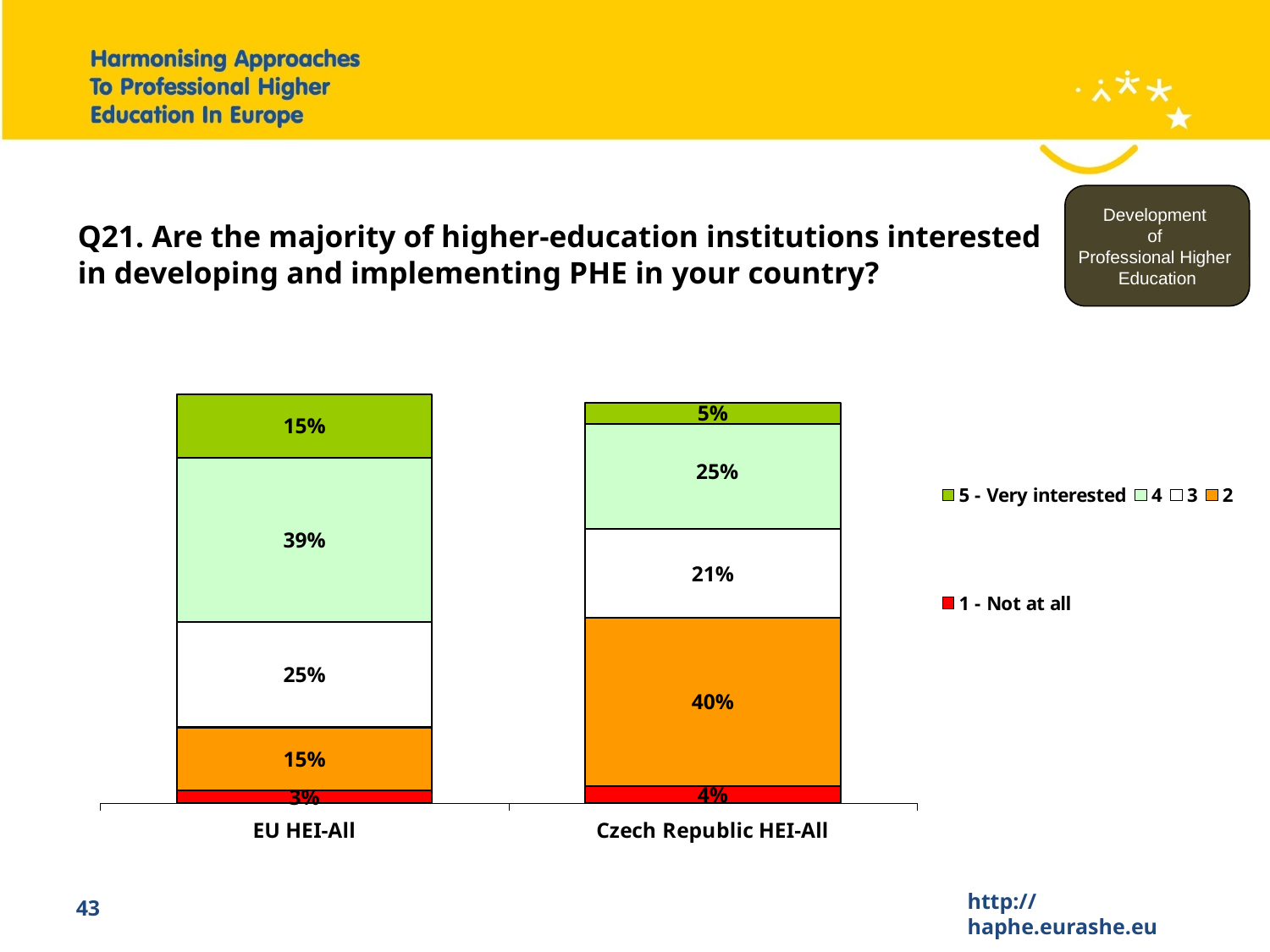
Which category has the larger '5 - Very interested' segment, EU HEI-All or Czech Republic HEI-All? EU HEI-All What is the difference between the '2' segment for Czech Republic HEI-All and the '2' segment for EU HEI-All? 25% How many series does the chart legend list? 5 What is the value of the '5 - Very interested' segment for Czech Republic HEI-All? 5% How many categories are shown on the x axis of the chart? 2 What is the label of the first series in the chart legend? 5 - Very interested What kind of chart is shown on the slide? Stacked bar chart What is the value of the '2' segment for Czech Republic HEI-All? 40% Which segment is the largest within the Czech Republic HEI-All bar? 2 What is the value of the '3' segment for EU HEI-All? 25% What is the value of the '4' segment for EU HEI-All? 39% What is the value of the '1 - Not at all' segment for Czech Republic HEI-All? 4%